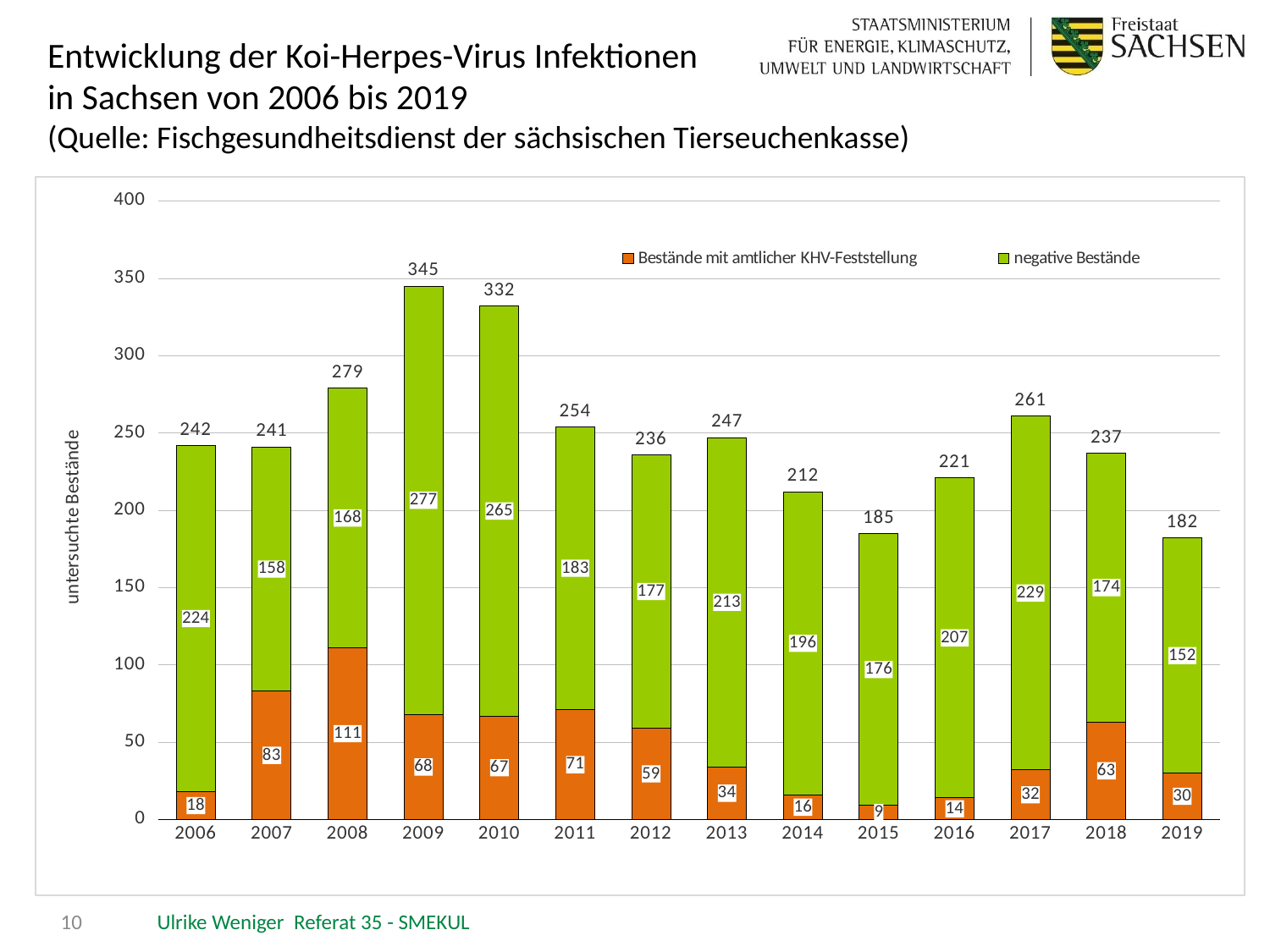
What is the value for 'negative Bestände' in 2009? 277 How many years are shown on the x axis? 14 Which year has the lowest value for 'Bestände mit amtlicher KHV-Feststellung'? 2015 What is the label of the y axis? untersuchte Bestände What kind of chart is shown on the slide? Stacked bar chart How many series does the legend list? 2 What is the difference between the total for 2017 and the total for 2019? 79 Is the total for 2014 greater or less than 200? greater Which year has the highest total of untersuchte Bestände? 2009 What is the total number of untersuchte Bestände in 2010? 332 Which is larger: the value for 'negative Bestände' in 2013 or in 2016? 2013 What is the value for 'Bestände mit amtlicher KHV-Feststellung' in 2008? 111